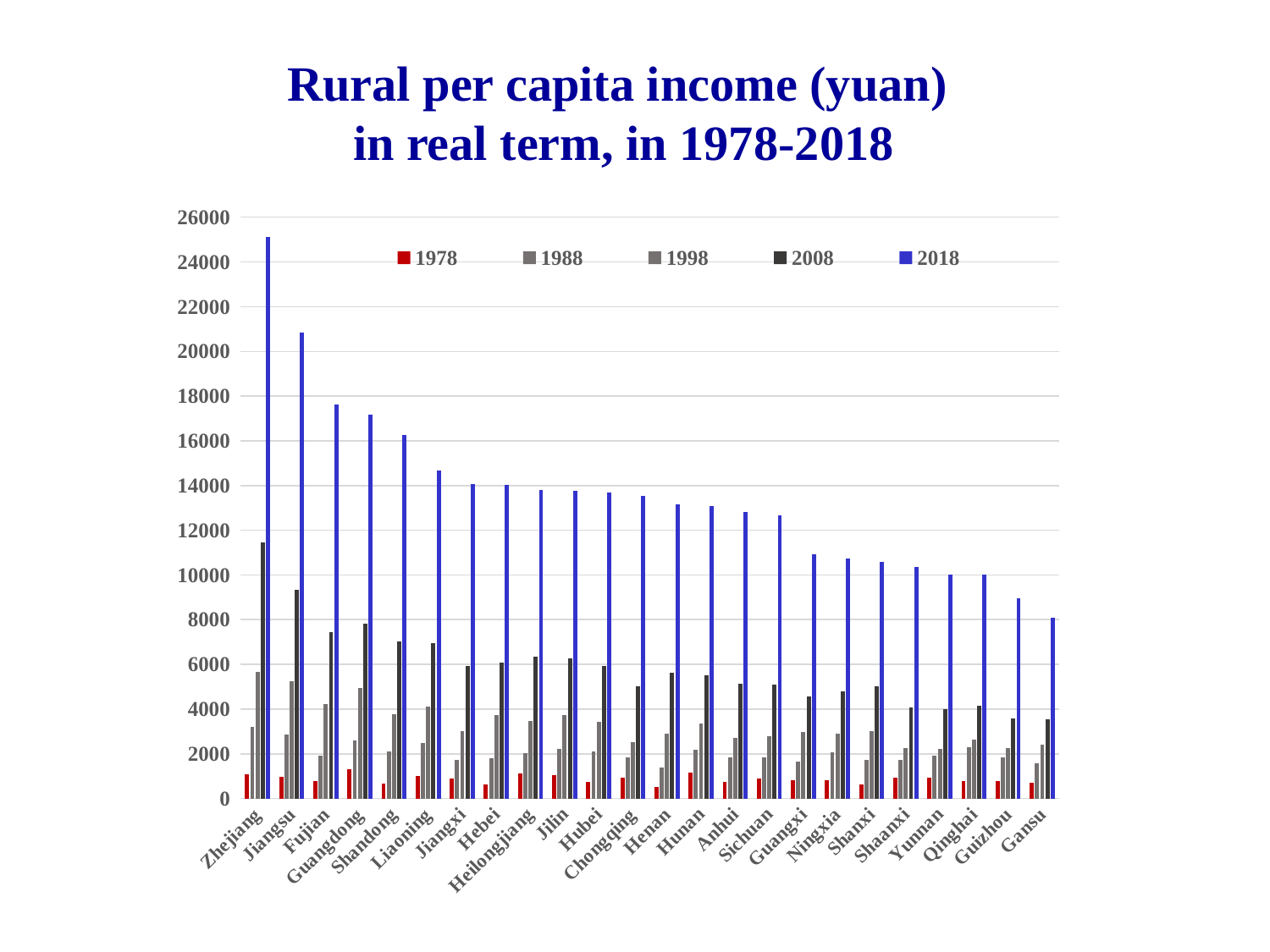
Is the 2018 value for Gansu greater or less than 10000? less Is the 2008 value for Zhejiang greater or less than 10000? greater Which is larger, the 2018 value for Jiangsu or the 2018 value for Fujian? Jiangsu Is the 2018 value for Zhejiang greater or less than 24000? greater Do the 2018 values rise or fall moving from left to right along the x axis? fall Which province has the highest rural per capita income in 2018? Zhejiang Which province has the lowest rural per capita income in 2018? Gansu How many series does the legend list? 5 How many provinces are shown on the x axis? 24 What type of chart is shown on the slide? bar chart Which colour represents the 2018 series in the legend? blue